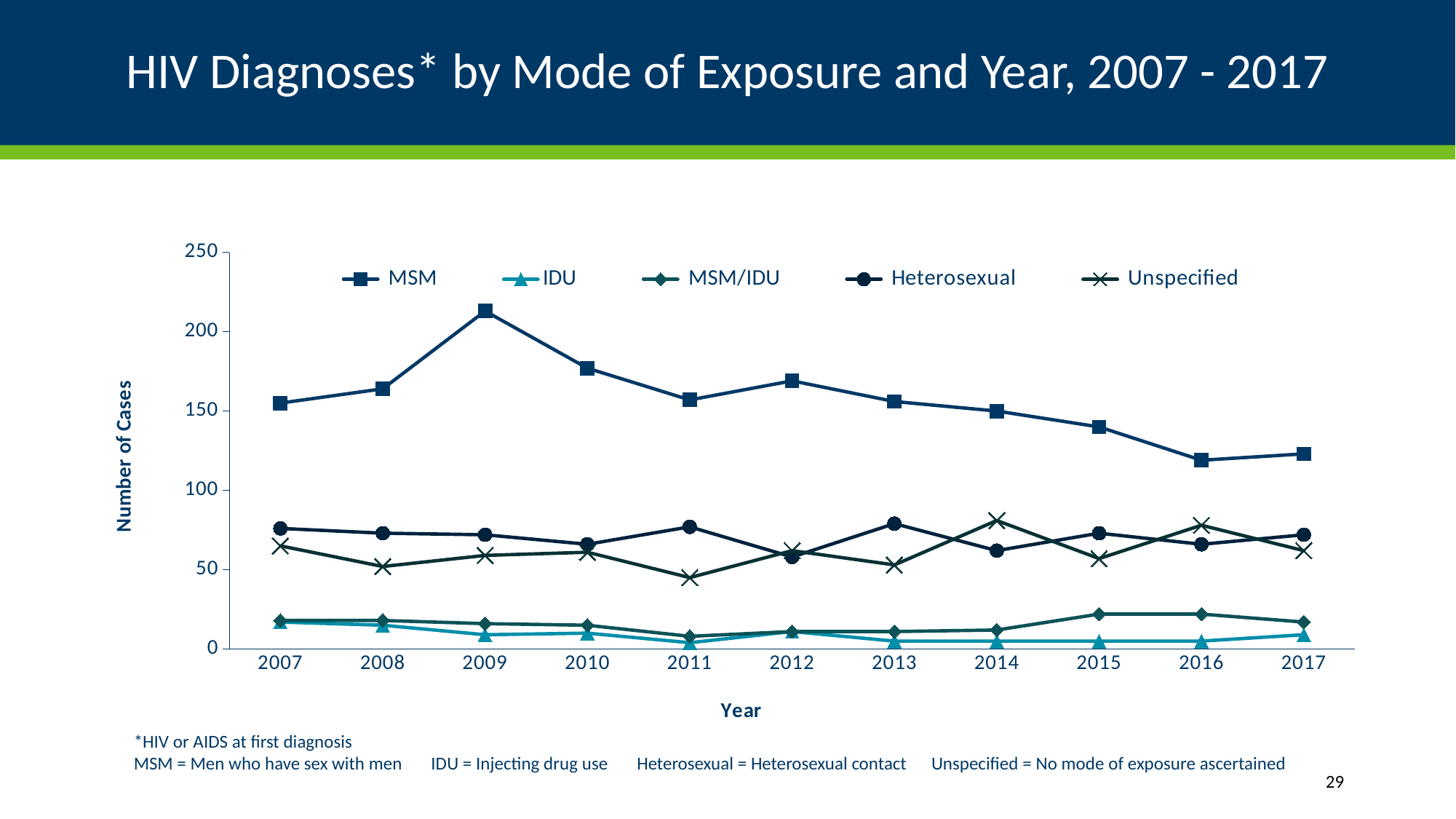
Is the value for Heterosexual in 2007 greater or less than 50? greater Is the value for MSM in 2017 greater or less than 150? less How many series does the legend list? 5 What kind of chart is shown on the slide? line chart How many years are plotted along the x axis? 11 Does the MSM series generally rise or fall from 2009 to 2017? fall Is the value for IDU in 2011 greater or less than 50? less In which year does the MSM series reach its highest value? 2009 Which mode of exposure has the highest number of cases across all years? MSM Which is larger, the MSM value in 2007 or the MSM value in 2009? 2009 Which is larger in 2015, the MSM/IDU value or the IDU value? MSM/IDU